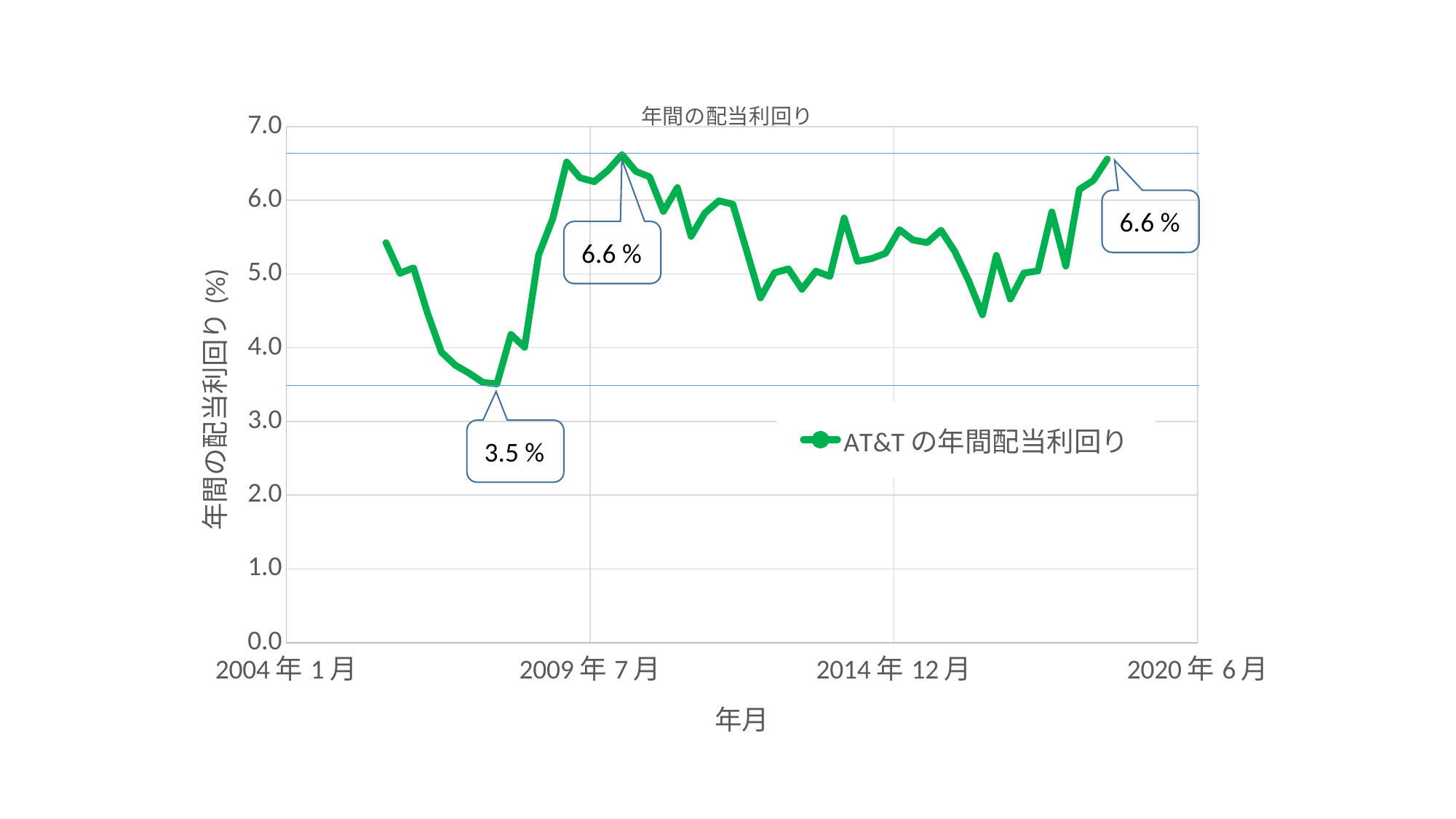
What is the maximum value shown on the vertical axis? 7.0 Is the value at 2009年7月 greater or less than 6.0? greater Does the dividend yield rise or fall from the start of the series to the point labeled 3.5％? fall What kind of chart is shown on the slide? line chart How many series does the legend list? 1 Which is larger: the value labeled near 2008 or the value labeled near 2020? the value near 2020 (6.6％) What is the highest value labeled on the line? 6.6％ What series name is shown in the legend? AT&T の年間配当利回り What is the lowest value labeled on the line? 3.5％ What is the difference between the labeled peak value of 6.6％ and the labeled low value of 3.5％? 3.1 percentage points What is the title of the chart? 年間の配当利回り Is the value at 2014年12月 greater or less than 6.0? less